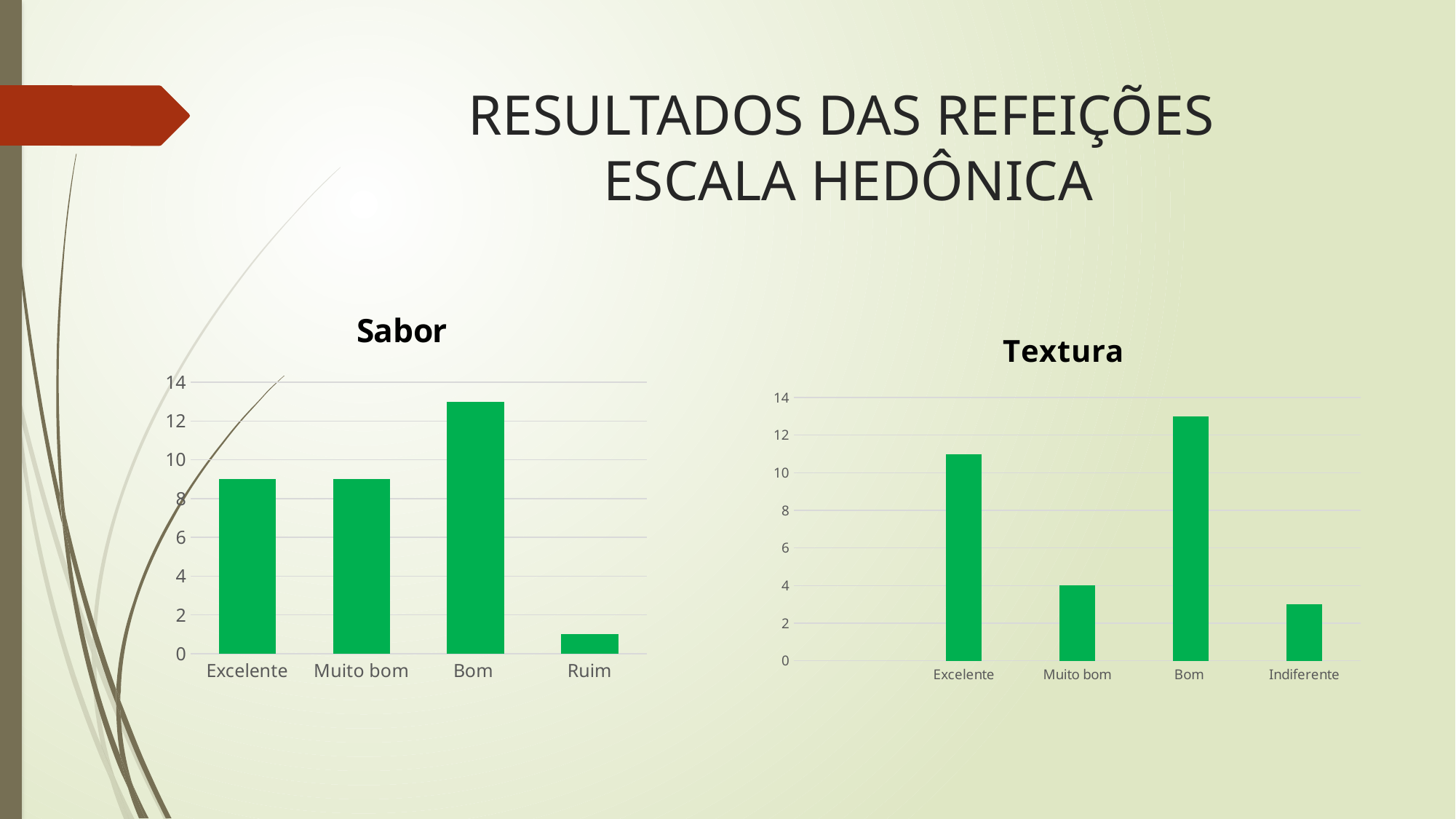
In the Sabor chart, is the value for Bom greater or less than 12? greater In the Textura chart, is the value for Muito bom greater or less than 6? less In the Sabor chart, which category has the highest value? Bom In the Textura chart, which is larger, the value for Excelente or the value for Indiferente? Excelente In the Sabor chart, is the value for Excelente greater or less than 10? less What is the title of the chart on the right side of the slide? Textura In the Textura chart, which category has the highest value? Bom What kind of chart is the Sabor chart? bar chart In the Sabor chart, which category has the lowest value? Ruim How many categories are shown on the x axis of the Sabor chart? 4